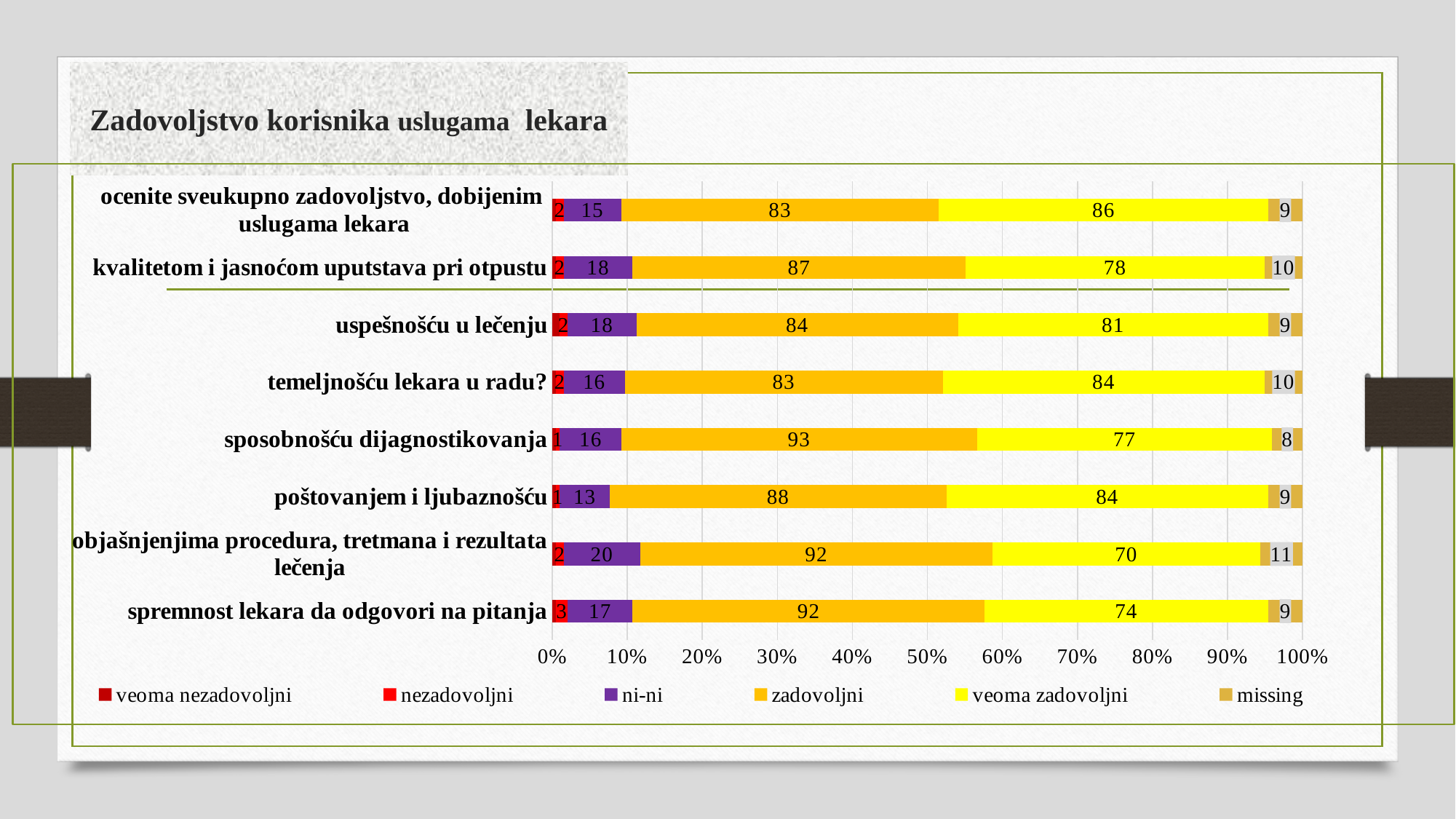
What is the 'veoma zadovoljni' value for 'ocenite sveukupno zadovoljstvo, dobijenim uslugama lekara'? 86 What kind of chart is shown on the slide? Stacked bar chart What is the 'ni-ni' value for 'poštovanjem i ljubaznošću'? 13 How many series does the legend list? 6 For 'objašnjenjima procedura, tretmana i rezultata lečenja', what is the difference between the 'zadovoljni' and 'veoma zadovoljni' values? 22 What is the title of the chart on the slide? Zadovoljstvo korisnika uslugama lekara Which category has the lowest 'veoma zadovoljni' value? objašnjenjima procedura, tretmana i rezultata lečenja What is the 'zadovoljni' value for 'sposobnošću dijagnostikovanja'? 93 Which category has the highest 'veoma zadovoljni' value? ocenite sveukupno zadovoljstvo, dobijenim uslugama lekara Which has the larger 'zadovoljni' value: 'spremnost lekara da odgovori na pitanja' or 'uspešnošću u lečenju'? spremnost lekara da odgovori na pitanja How many categories (questions) are plotted on the chart? 8 What is the 'ni-ni' value for 'objašnjenjima procedura, tretmana i rezultata lečenja'? 20